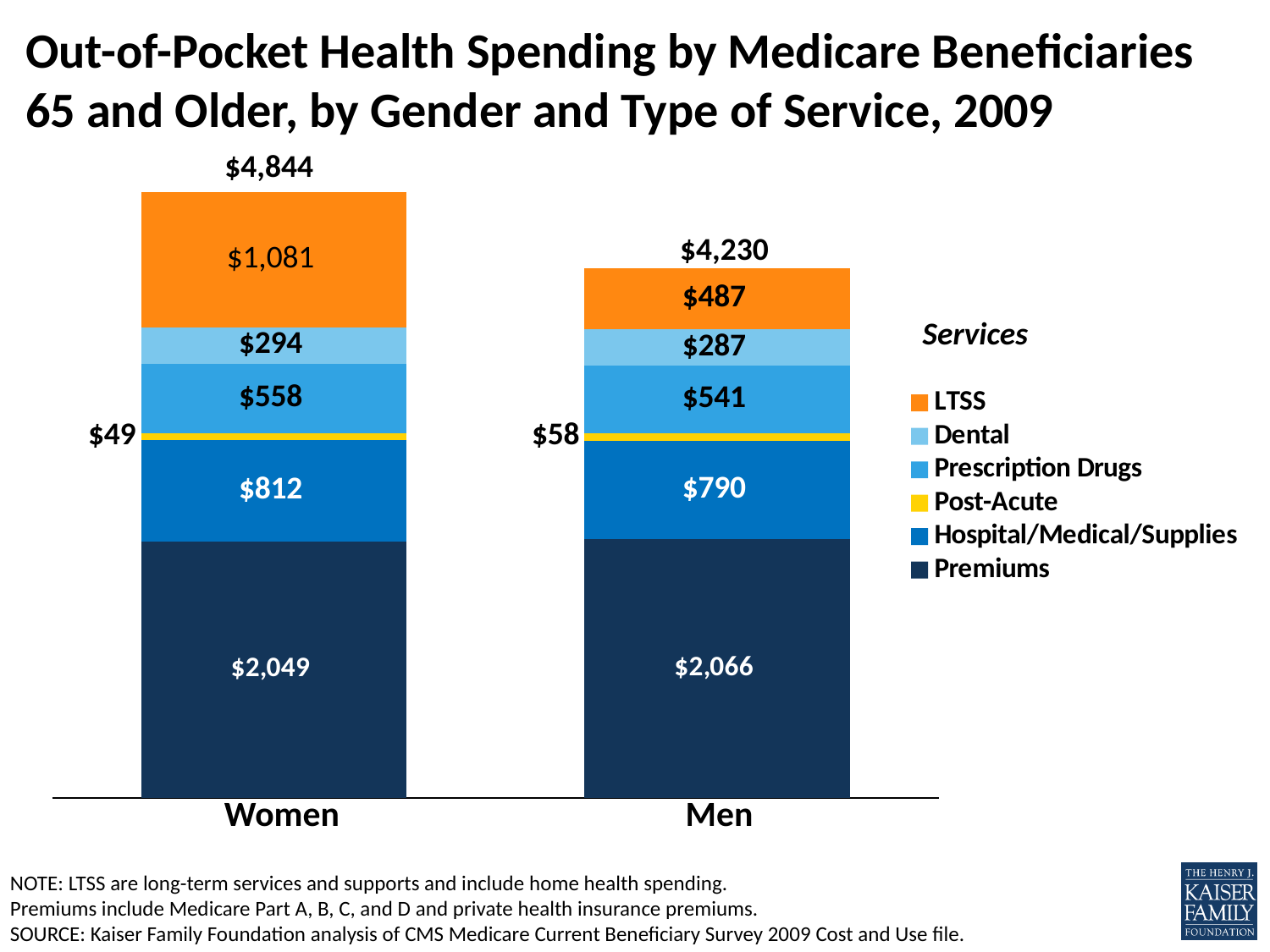
What type of chart is shown on the slide? Stacked bar chart How many service categories does the legend list? 6 What is the Post-Acute spending value for Women? $49 What is the Premiums spending value for Men? $2,066 What is the Prescription Drugs spending value for Men? $541 What is the difference between LTSS spending for Women and for Men? $594 Which gender has the higher Hospital/Medical/Supplies spending, Women or Men? Women What is the total out-of-pocket spending for Women? $4,844 What is the LTSS spending value for Women? $1,081 Which service category is the smallest component of spending for Men? Post-Acute Which service category is the largest component of spending for Women? Premiums What is the total out-of-pocket spending for Men? $4,230